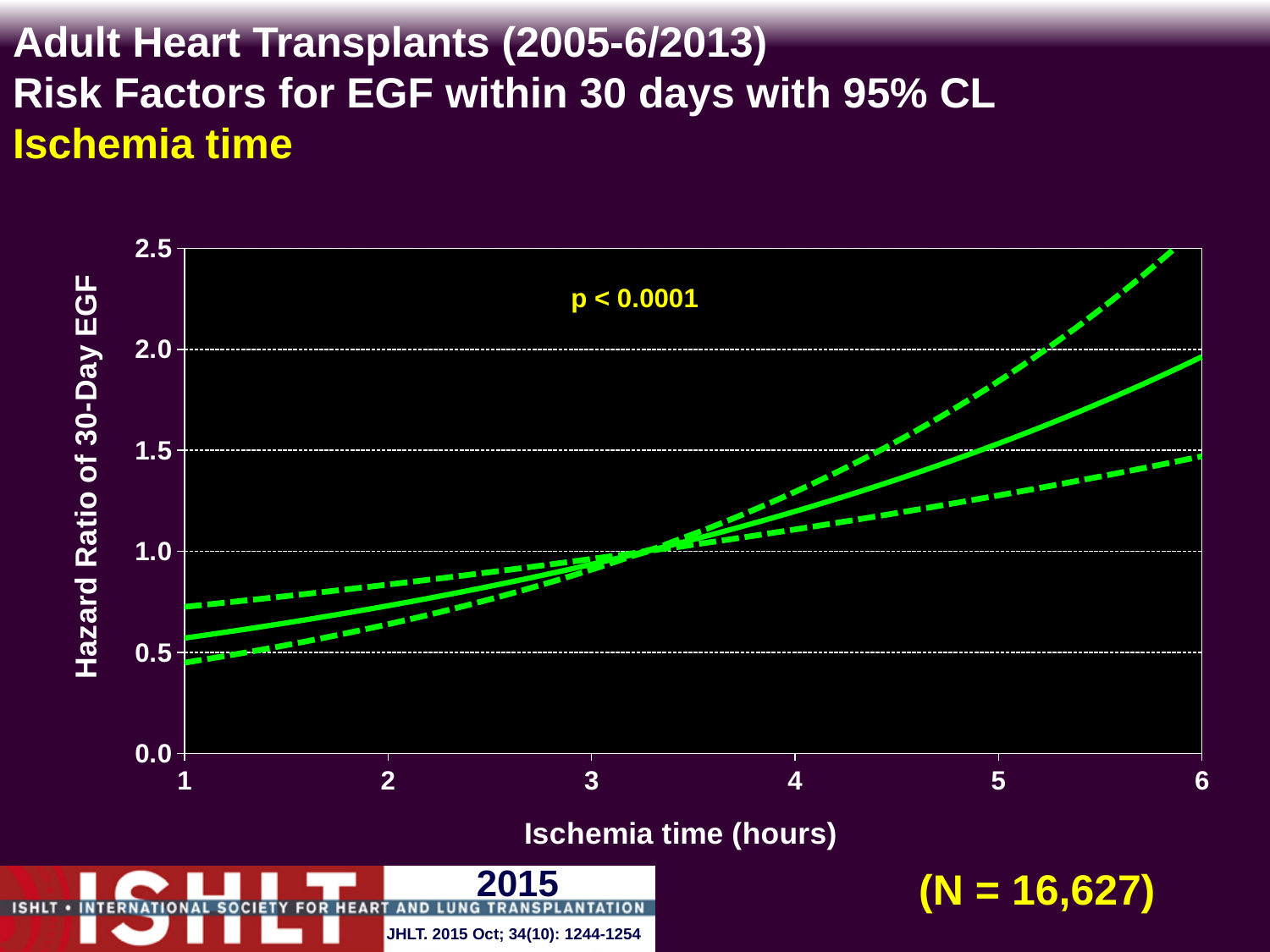
Is the hazard ratio (solid line) higher at 6 hours or at 1 hour of ischemia time? 6 hours Is the hazard ratio (solid line) at an ischemia time of 1 hour greater or less than 1.0? less Is the lower 95% confidence limit (lower dashed line) at 6 hours greater or less than 2.0? less Is the hazard ratio (solid line) at an ischemia time of 6 hours greater or less than 1.5? greater How many tick values are labelled on the x axis (ischemia time)? 6 What kind of chart is shown on the slide? line chart How many lines are plotted on the chart? 3 How does the hazard ratio of 30-day EGF change as ischemia time increases from 1 to 6 hours? It rises What sample size (N) is shown on the slide? N = 16,627 What p-value is printed on the chart? p < 0.0001